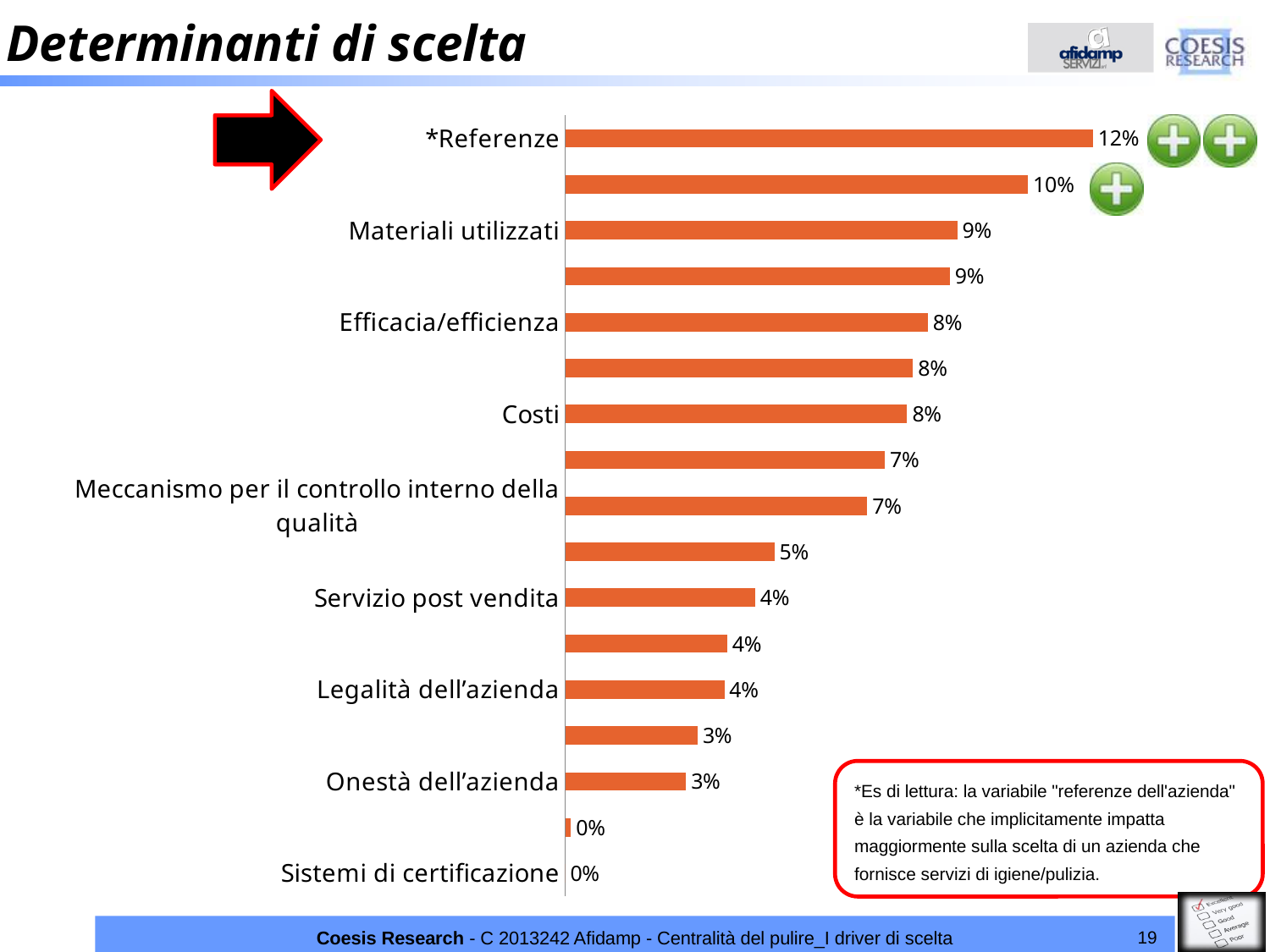
What is the value for Servizio post vendita? 4% How many bars are plotted in the chart? 17 What is the value for Materiali utilizzati? 9% Which is larger, the value for Materiali utilizzati or the value for Costi? Materiali utilizzati What is the value for Sistemi di certificazione? 0% What is the difference between the values for *Referenze and Materiali utilizzati? 3% What kind of chart is shown on the slide? Bar chart What is the value for *Referenze? 12% What is the value for Onestà dell'azienda? 3% Which category has the highest value? *Referenze What is the value for Meccanismo per il controllo interno della qualità? 7% What is the value for Costi? 8%